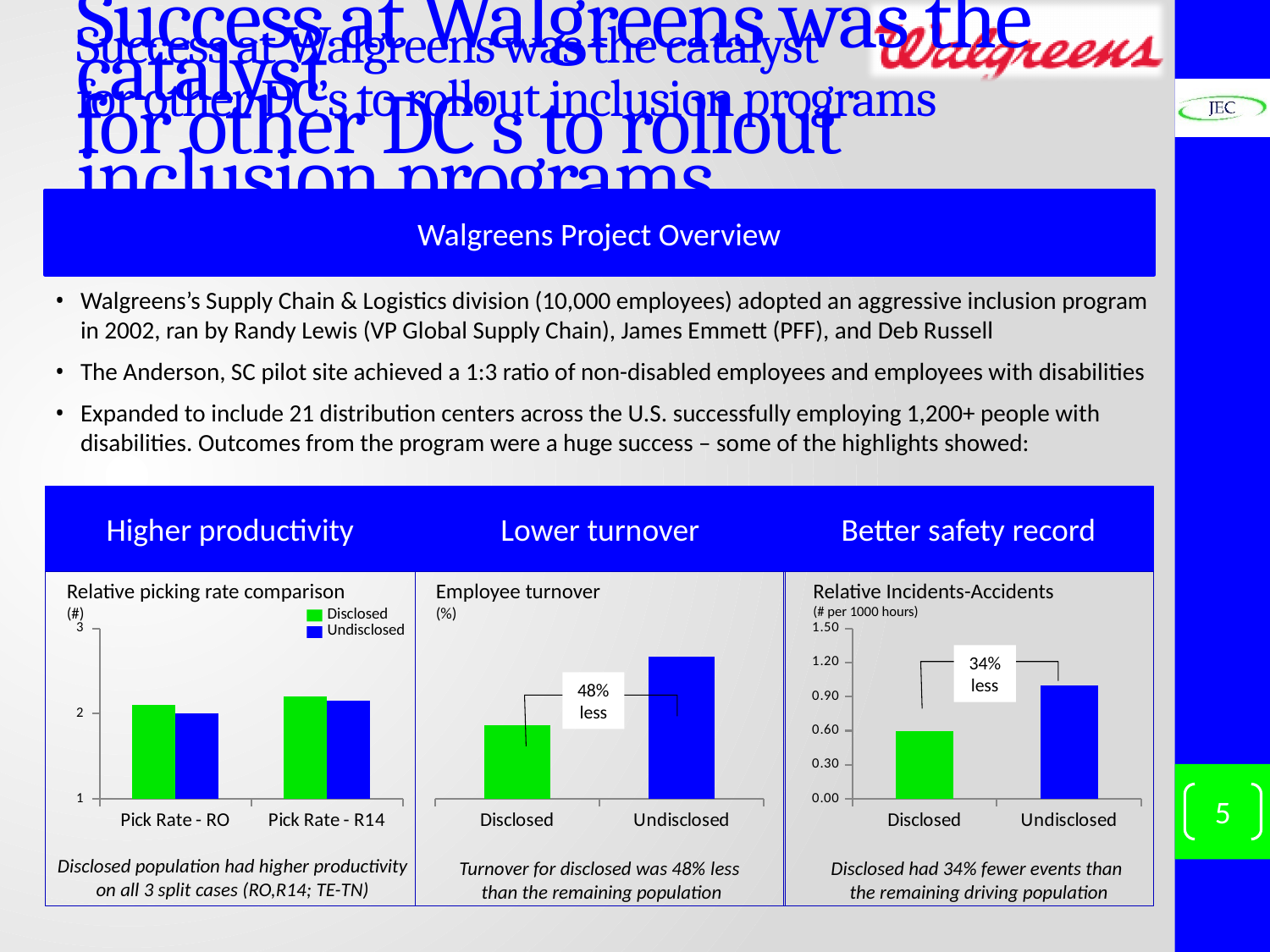
In the 'Relative Incidents-Accidents' chart on the right, which category has the highest value? Undisclosed In the 'Relative picking rate comparison' chart, how many series does the legend list? 2 In the 'Relative Incidents-Accidents' chart, is the value for Disclosed greater or less than 0.90? less In the 'Relative Incidents-Accidents' chart, is the value for Undisclosed greater or less than 1.20? less In the 'Relative Incidents-Accidents' chart, is the value for Undisclosed greater or less than 0.90? greater In the 'Employee turnover' chart in the middle, which category has the higher bar? Undisclosed In the 'Employee turnover' chart, what percentage less is the Disclosed turnover according to the annotation? 48% less In the 'Employee turnover' chart, which category has the lower bar? Disclosed In the 'Relative picking rate comparison' chart, what are the two legend entries? Disclosed, Undisclosed What kind of chart is the 'Relative picking rate comparison' chart on the left? bar chart In the 'Relative Incidents-Accidents' chart, which is larger, the Disclosed value or the Undisclosed value? Undisclosed In the 'Relative picking rate comparison' chart, how many categories are shown on the x axis? 2